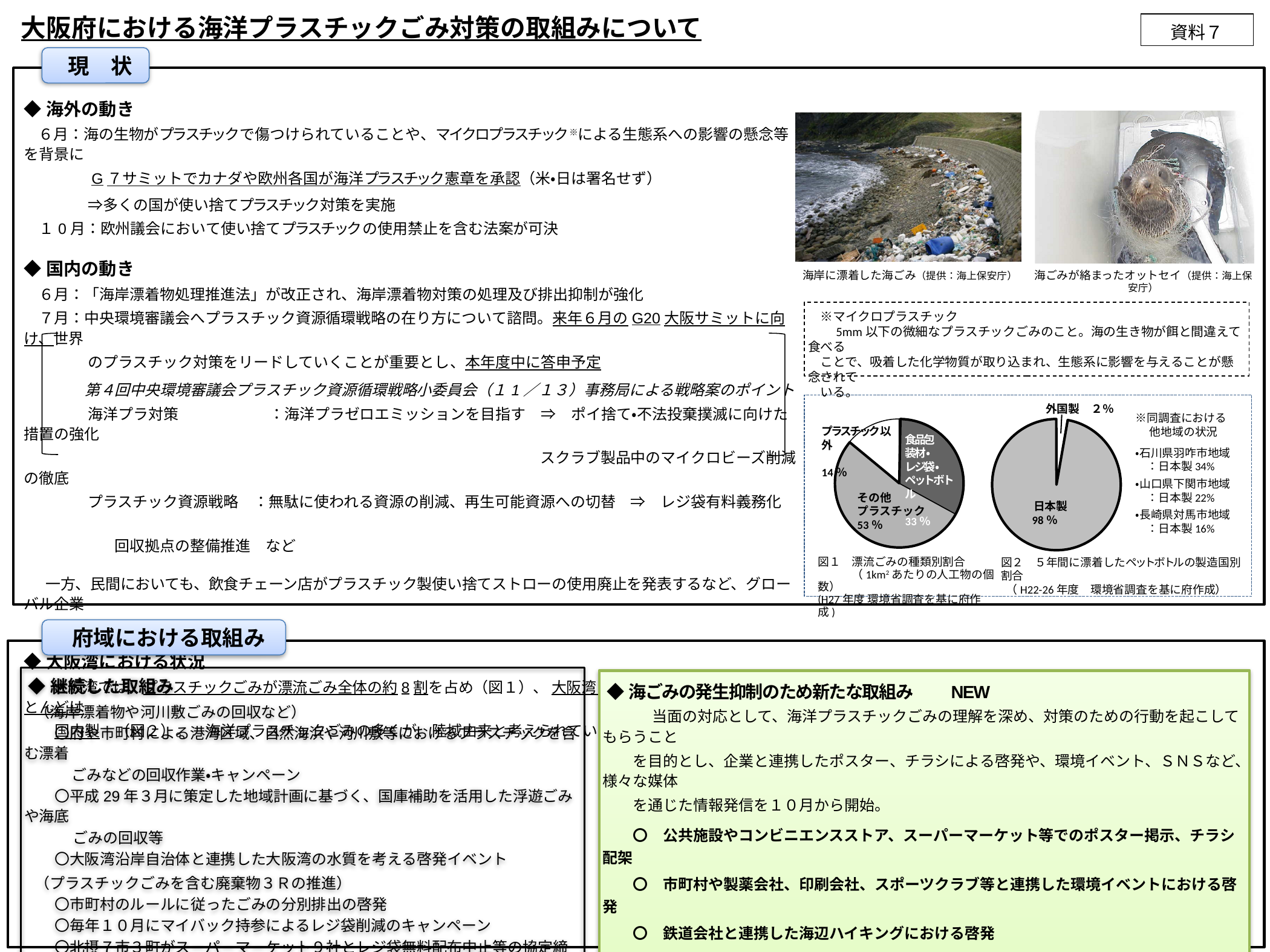
In 図2 (5年間に漂着したペットボトルの製造国別割合), what is the difference between the shares of 日本製 and 外国製? 96％ In 図2 (5年間に漂着したペットボトルの製造国別割合), what share is labelled for 日本製? 98％ In 図1 (漂流ごみの種類別割合), what share is labelled for プラスチック以外? 14％ In 図1 (漂流ごみの種類別割合), how many categories are shown? 3 In 図2 (5年間に漂着したペットボトルの製造国別割合), which is larger, 日本製 or 外国製? 日本製 In 図1 (漂流ごみの種類別割合), what share is labelled for その他プラスチック? 53％ In 図1 (漂流ごみの種類別割合), what is the difference between the shares of その他プラスチック and 食品包装材・レジ袋・ペットボトル? 20％ In 図2 (5年間に漂着したペットボトルの製造国別割合), what share is labelled for 外国製? 2％ In 図1 (漂流ごみの種類別割合), what share is labelled for 食品包装材・レジ袋・ペットボトル? 33％ In 図1 (漂流ごみの種類別割合), which category has the smallest share? プラスチック以外 In 図1 (漂流ごみの種類別割合), which category has the largest share? その他プラスチック What type of chart is 図2 (5年間に漂着したペットボトルの製造国別割合)? Pie chart